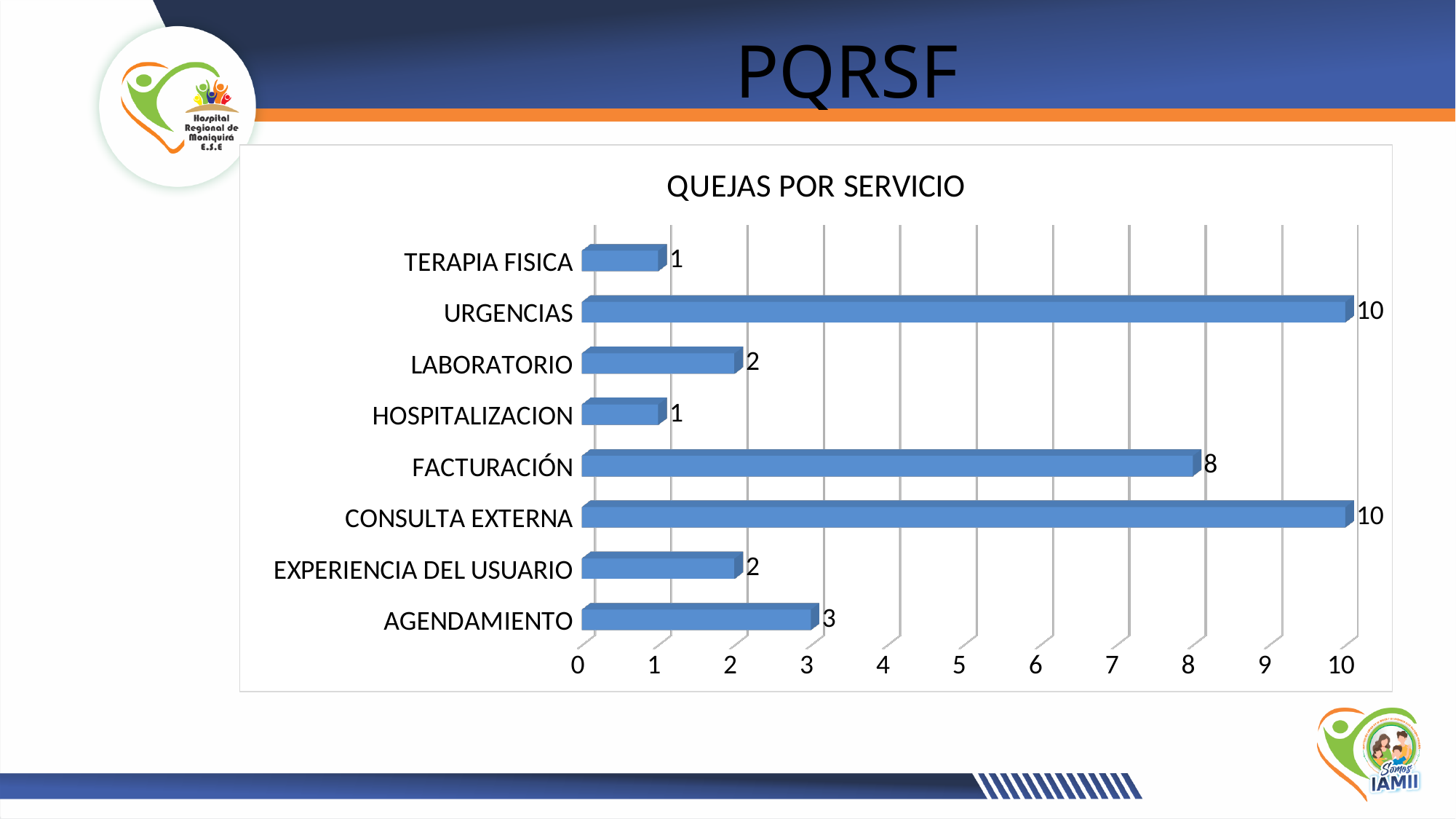
What is the title of the chart? QUEJAS POR SERVICIO What is the value for LABORATORIO? 2 What is the value for AGENDAMIENTO? 3 What is the highest value shown on the x axis? 10 What kind of chart is shown on the slide? Bar chart How many categories are shown in the chart? 8 What is the value for FACTURACIÓN? 8 Which category has the lowest value? TERAPIA FISICA and HOSPITALIZACION (both 1) What is the difference between the values for URGENCIAS and FACTURACIÓN? 2 Which is larger, the value for AGENDAMIENTO or the value for EXPERIENCIA DEL USUARIO? AGENDAMIENTO What is the difference between the values for CONSULTA EXTERNA and HOSPITALIZACION? 9 What is the value for URGENCIAS? 10